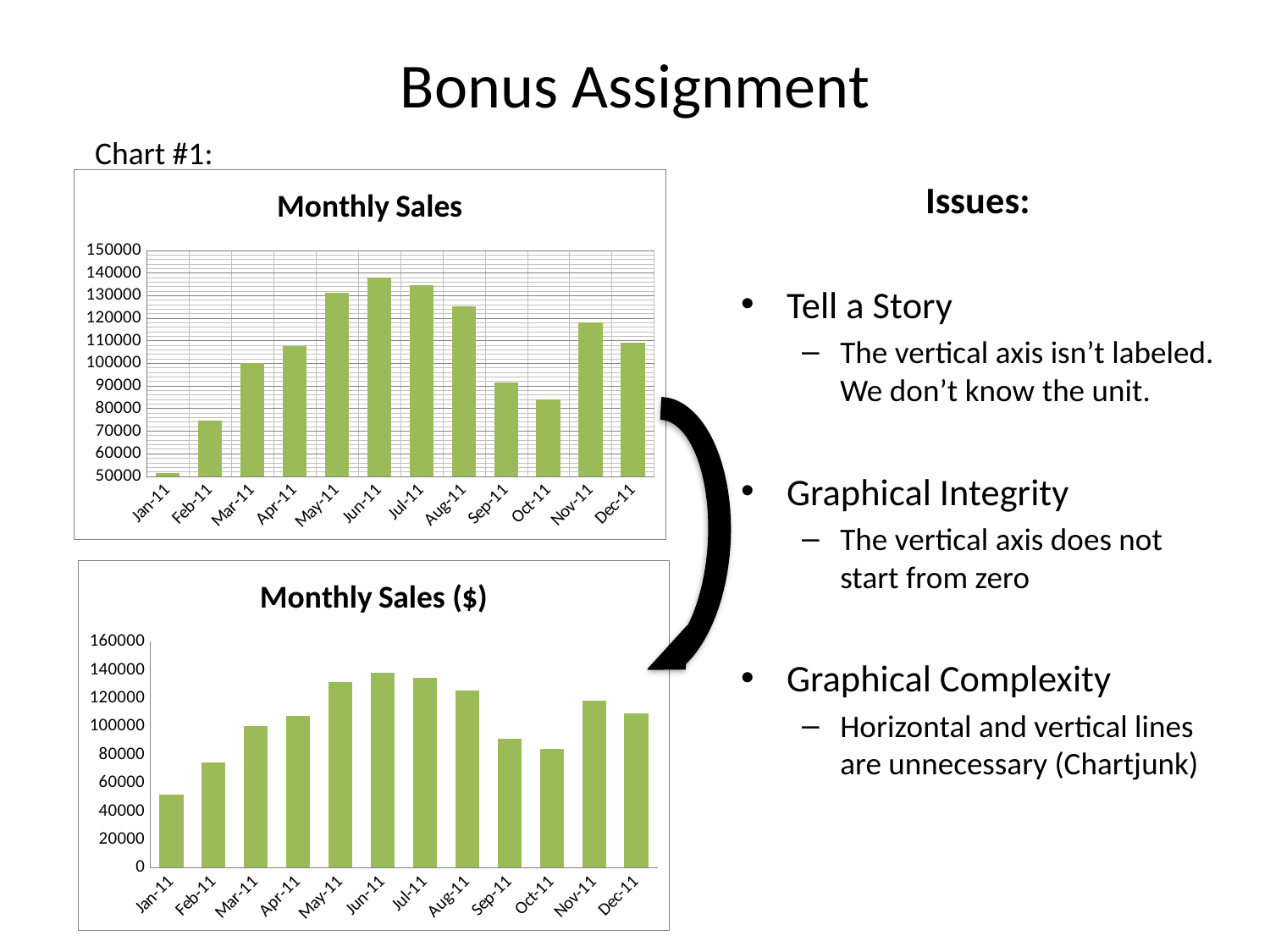
What is the title of the bottom chart on the slide? Monthly Sales ($) In the top chart titled "Monthly Sales", which is larger, the value for Mar-11 or the value for Aug-11? Aug-11 What value does the vertical axis of the top chart titled "Monthly Sales" start at? 50000 In the bottom chart titled "Monthly Sales ($)", which is larger, the value for Nov-11 or the value for Sep-11? Nov-11 In the bottom chart titled "Monthly Sales ($)", do the values rise or fall from Jan-11 to Jun-11? rise In the bottom chart titled "Monthly Sales ($)", which month has the lowest bar? Jan-11 In the bottom chart titled "Monthly Sales ($)", which month has the highest bar? Jun-11 In the top chart titled "Monthly Sales", is the value for Jun-11 greater or less than 130000? greater In the top chart titled "Monthly Sales", how many months are plotted on the x axis? 12 In the top chart titled "Monthly Sales", is the value for Feb-11 greater or less than 80000? less In the bottom chart titled "Monthly Sales ($)", is the value for Oct-11 greater or less than 100000? less In the top chart titled "Monthly Sales", what kind of chart is shown? bar chart